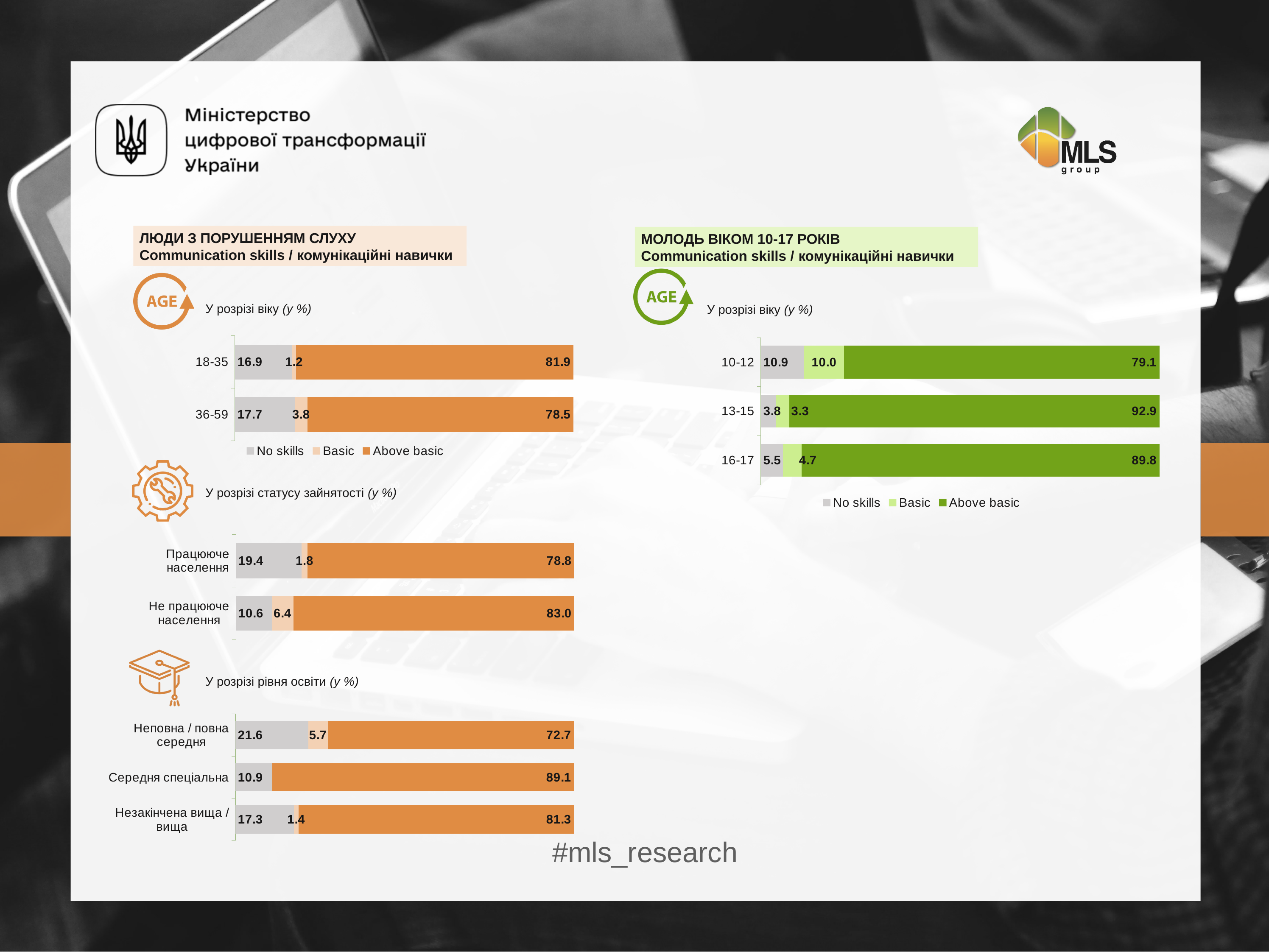
In the education chart for people with hearing impairment (left), what is the 'Basic' value for 'Неповна / повна середня'? 5.7 In the age chart for youth aged 10-17 (right), which age group has the highest 'Above basic' value? 13-15 In the age chart for people with hearing impairment (left, 'У розрізі віку'), what is the 'Above basic' value for the 18-35 group? 81.9 In the age chart for youth aged 10-17 (right, 'У розрізі віку'), what is the 'No skills' value for the 10-12 group? 10.9 How many series does the legend list in the age chart for people with hearing impairment (left)? 3 In the age chart for youth aged 10-17 (right), what is the difference between the 'Above basic' values for 13-15 and 10-12? 13.8 What colour represents the 'Above basic' series in the charts for youth aged 10-17 (right)? Green In the education chart for people with hearing impairment (left, 'У розрізі рівня освіти'), which category has the lowest 'Above basic' value? Неповна / повна середня How many age groups are shown in the age chart for youth aged 10-17 (right)? 3 What kind of chart is used in the employment status chart for people with hearing impairment (left)? Stacked horizontal bar chart In the employment status chart for people with hearing impairment (left, 'У розрізі статусу зайнятості'), what is the difference between the 'No skills' values for 'Працююче населення' and 'Не працююче населення'? 8.8 In the age chart for youth aged 10-17 (right), which is larger: the 'Basic' value for 10-12 or for 16-17? 10-12